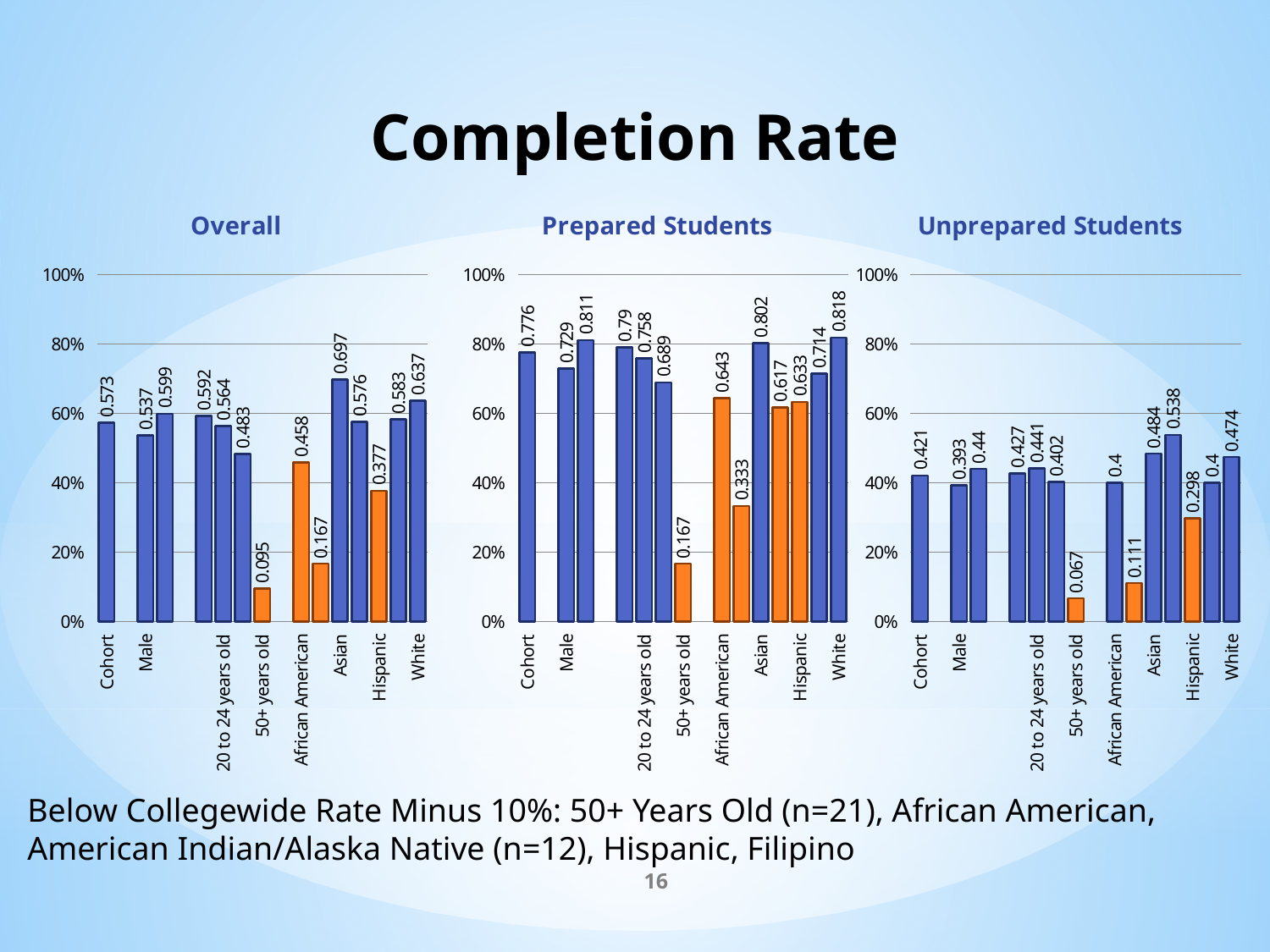
In the Unprepared Students chart, what is the completion rate for Hispanic students? 0.298 How many charts are shown on the slide? 3 In the Overall chart, which labeled category has the lowest completion rate? 50+ years old What kind of chart is used for the Prepared Students data? bar chart In the Overall chart, what is the difference between the completion rates for White and Hispanic students? 0.26 In the Unprepared Students chart, is the completion rate for African American students greater or less than 60%? less In the Prepared Students chart, what is the completion rate for Asian students? 0.802 In the Overall chart, what is the completion rate for the Cohort? 0.573 In the Unprepared Students chart, what is the completion rate for 50+ years old? 0.067 In the Overall chart, which labeled category has the highest completion rate? Asian In the Prepared Students chart, which labeled category has the highest completion rate? White In the Prepared Students chart, which is larger, the completion rate for Male or for 20 to 24 years old? 20 to 24 years old